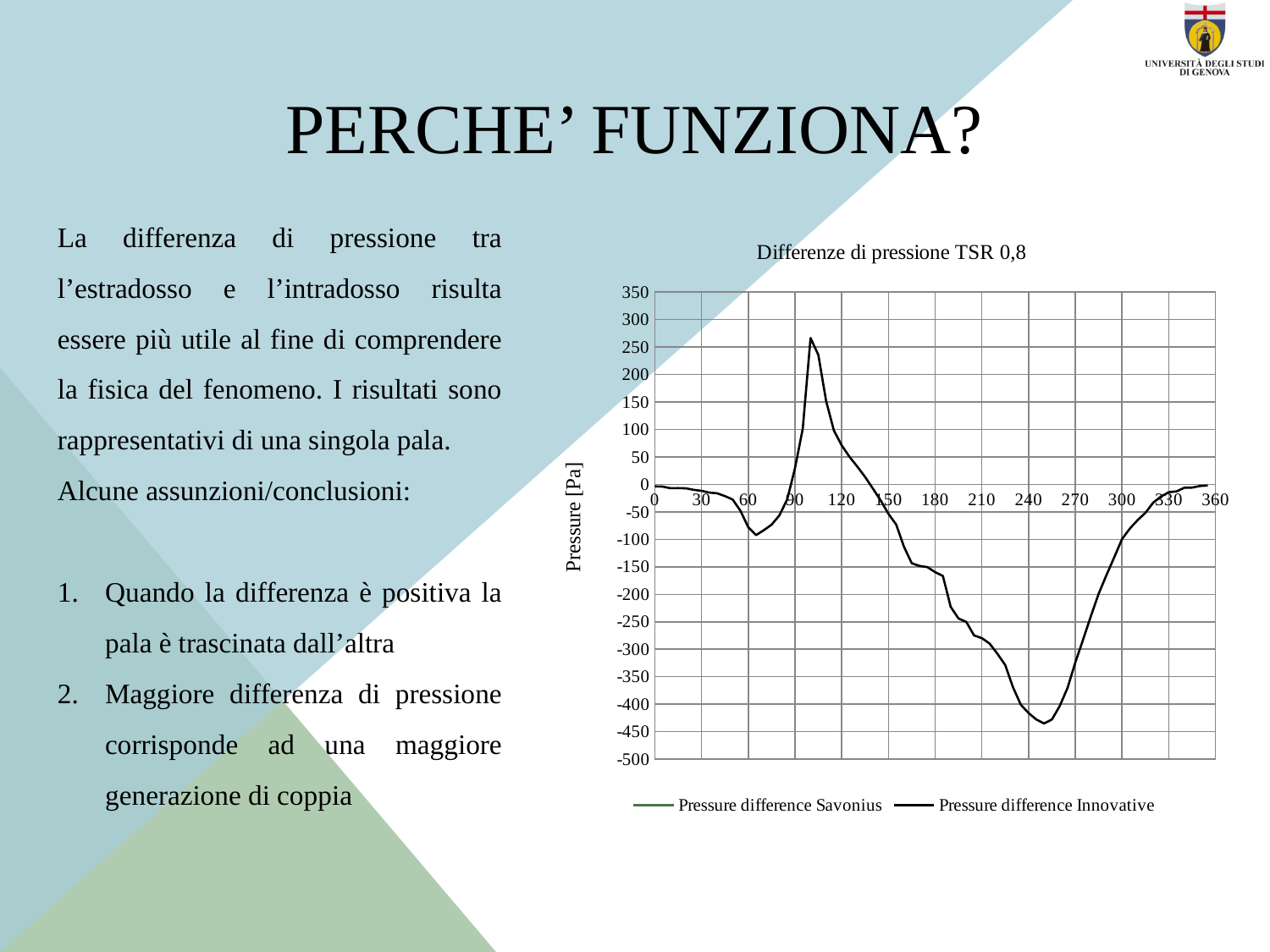
How many series does the chart legend list? 2 What kind of chart is shown on the slide? line chart What is the label of the vertical axis of the chart? Pressure [Pa] Is the value of the Pressure difference Innovative curve at 180 greater or less than -100? less What is the title of the chart? Differenze di pressione TSR 0,8 Is the value of the Pressure difference Innovative curve at 240 greater or less than -350? less Which is larger for the Pressure difference Innovative curve: the value at 120 or the value at 240? the value at 120 Is the lowest value of the Pressure difference Innovative curve greater or less than -400? less Do the values of the Pressure difference Innovative curve rise or fall between 270 and 360 on the x axis? rise Do the values of the Pressure difference Innovative curve rise or fall between 120 and 240 on the x axis? fall